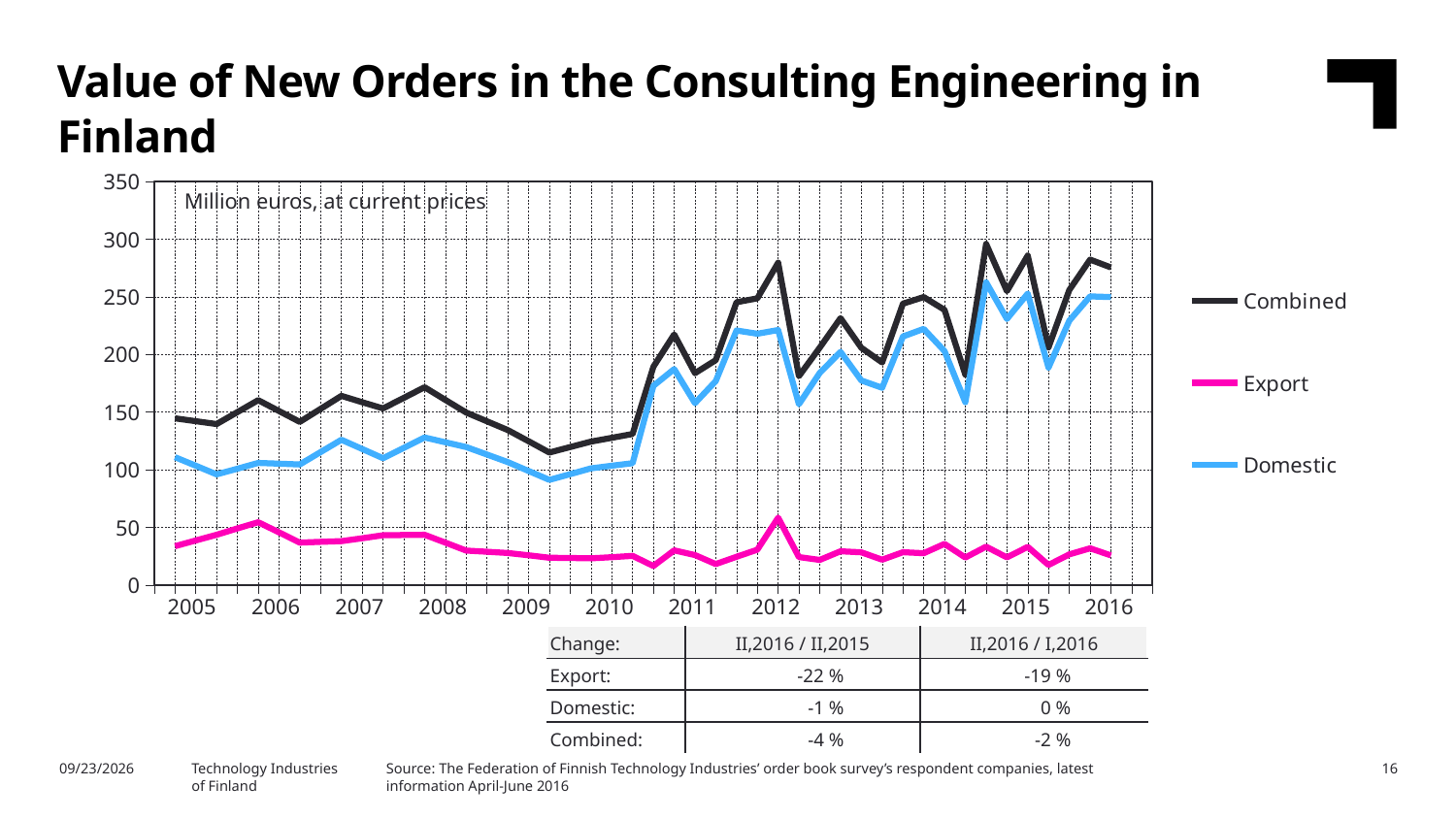
Which series has the highest values across the whole chart? Combined Is the value for Combined at the start of 2005 greater or less than 100? greater Does the Combined series rise or fall between 2009 and 2012? rise Is the value for Export at its 2012 peak greater or less than 100? less Is the value for Combined at the 2016 end of the chart greater or less than 250? greater Which is larger in 2016, the Combined value or the Export value? Combined What are the three series named in the legend? Combined, Export, Domestic How many series does the legend list? 3 What kind of chart is shown on the slide? line chart What unit is stated in the label inside the chart area? Million euros, at current prices Which series has the lowest values across the whole chart? Export